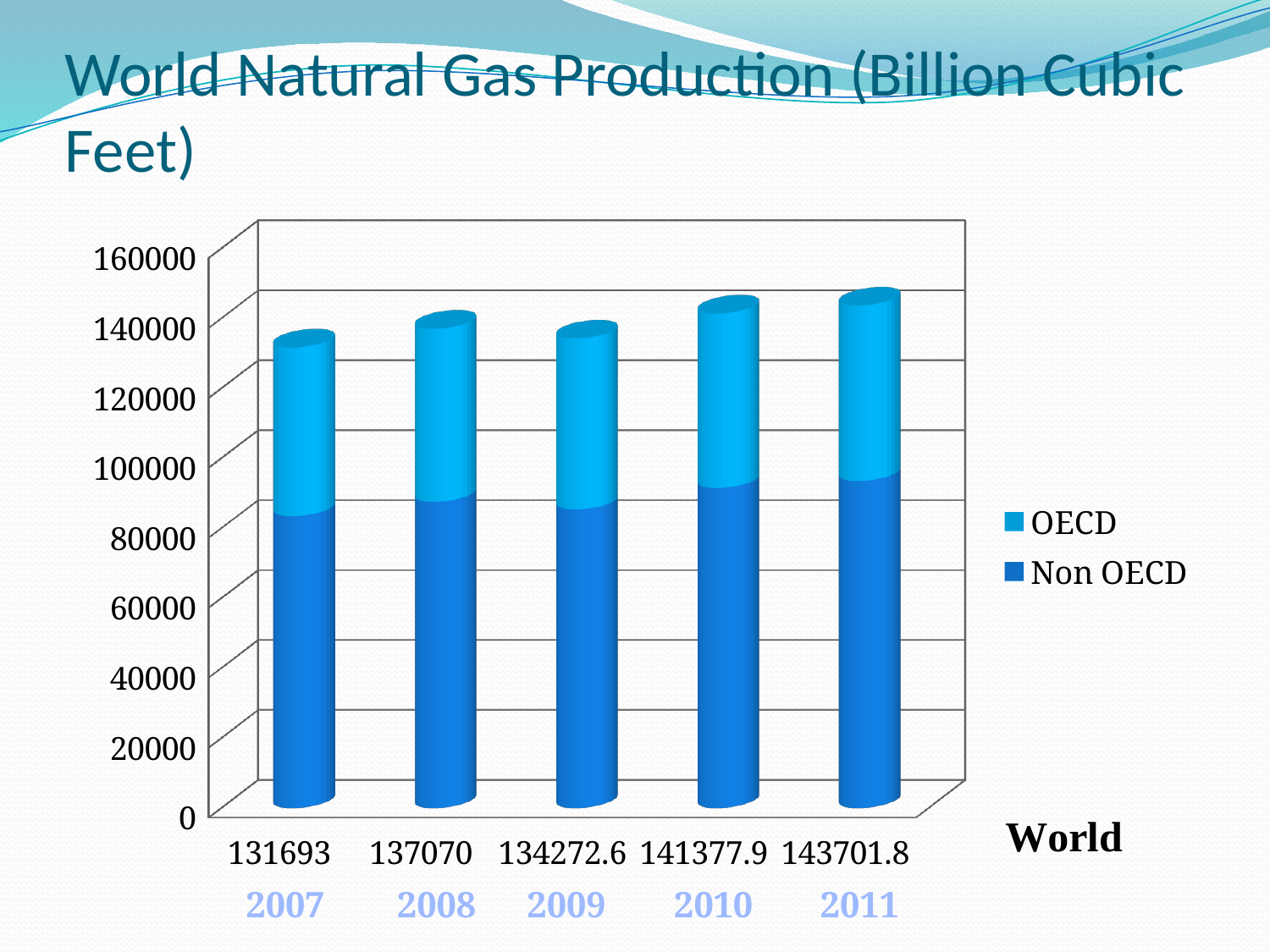
How many years are shown on the chart? 5 How many series does the legend list? 2 Which year has the larger world production value, 2008 or 2009? 2008 Which year has the lowest world natural gas production? 2007 What kind of chart is shown on the slide? Stacked bar chart What is the world natural gas production value shown for 2011? 143701.8 Which year has the highest world natural gas production? 2011 Is the Non OECD value for 2007 greater or less than 100000? less What is the world natural gas production value shown for 2007? 131693 What is the difference between the world production values for 2011 and 2007? 12008.8 What is the difference between the world production values for 2010 and 2009? 7105.3 What is the world natural gas production value shown for 2009? 134272.6